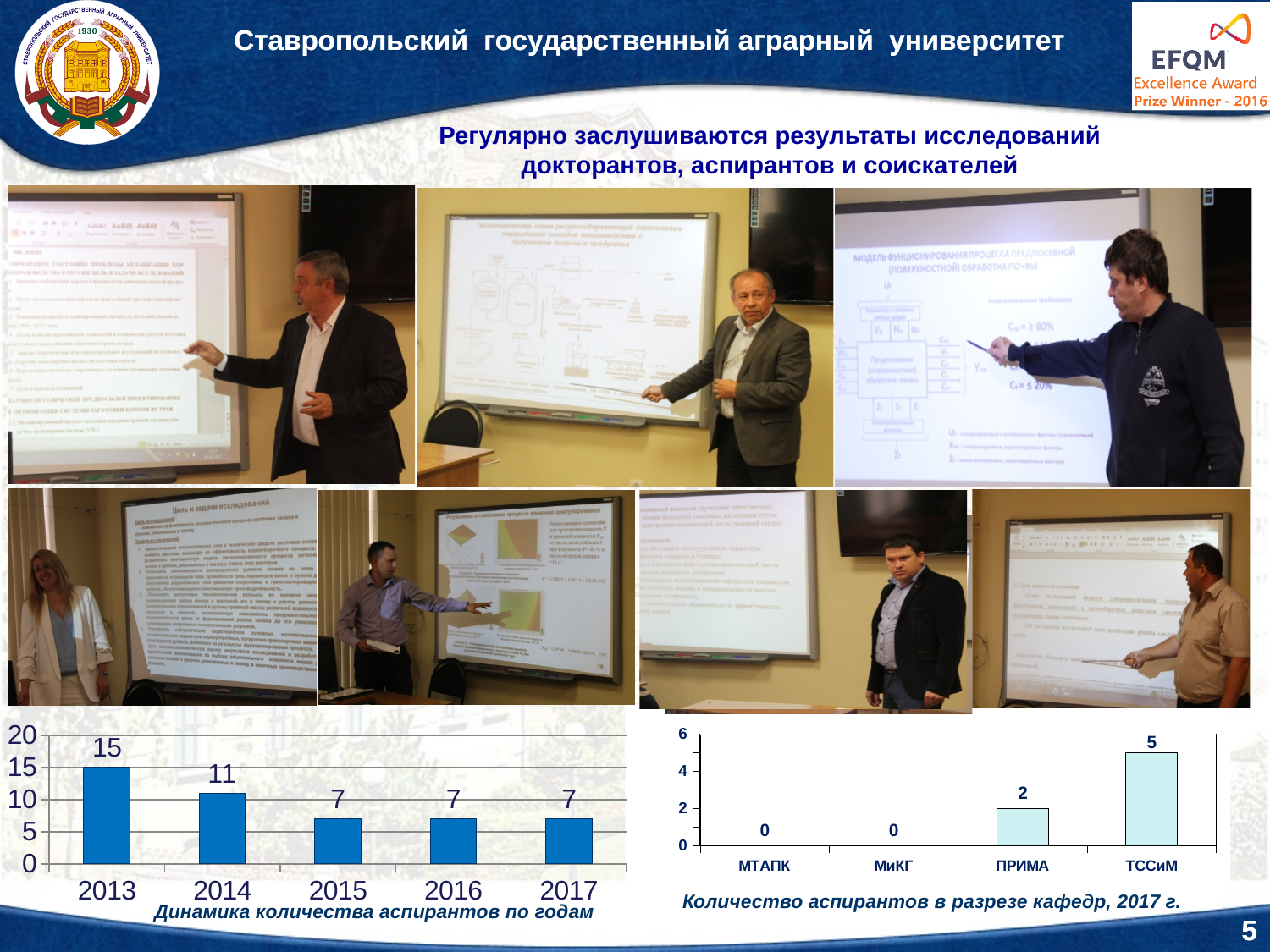
In the left chart 'Динамика количества аспирантов по годам', which year has the highest value? 2013 In the right chart 'Количество аспирантов в разрезе кафедр, 2017 г.', how many departments are shown on the x axis? 4 In the right chart 'Количество аспирантов в разрезе кафедр, 2017 г.', what is the difference between the values for ТССиМ and ПРИМА? 3 In the left chart 'Динамика количества аспирантов по годам', do the values rise or fall from 2013 to 2015? fall In the left chart 'Динамика количества аспирантов по годам', what is the value for 2014? 11 In the left chart 'Динамика количества аспирантов по годам', how many years are shown on the x axis? 5 In the right chart 'Количество аспирантов в разрезе кафедр, 2017 г.', which department has the highest value? ТССиМ In the right chart 'Количество аспирантов в разрезе кафедр, 2017 г.', what is the value for ТССиМ? 5 In the right chart 'Количество аспирантов в разрезе кафедр, 2017 г.', what is the value for ПРИМА? 2 In the left chart 'Динамика количества аспирантов по годам', what is the value for 2013? 15 In the left chart 'Динамика количества аспирантов по годам', what is the difference between the values for 2013 and 2014? 4 What kind of chart is the left chart 'Динамика количества аспирантов по годам'? bar chart